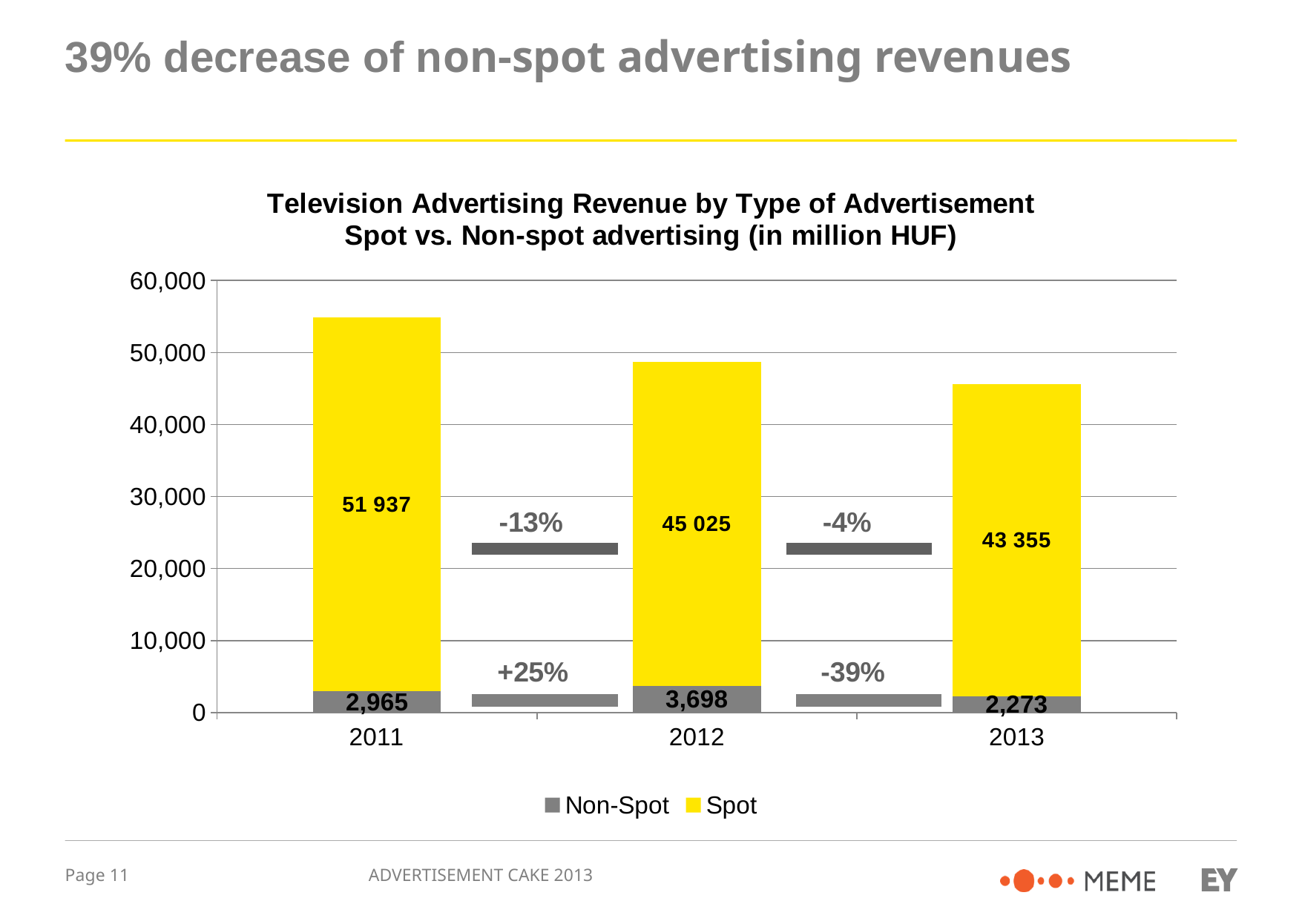
Is the Spot revenue in 2012 larger or smaller than the Spot revenue in 2013? larger How many years are shown on the x axis of the chart? 3 What is the Non-Spot advertising revenue for 2013? 2,273 What percentage change in Non-Spot revenue is shown between 2012 and 2013? -39% Which year has the lowest Spot advertising revenue? 2013 What is the difference between the Spot revenue in 2011 and in 2012? 6,912 Which year has the highest Non-Spot advertising revenue? 2012 What is the total television advertising revenue (Spot plus Non-Spot) for 2011? 54,902 How many series does the legend list? 2 What is the Spot advertising revenue for 2011? 51 937 What is the Spot advertising revenue for 2013? 43 355 What is the total television advertising revenue (Spot plus Non-Spot) for 2013? 45,628